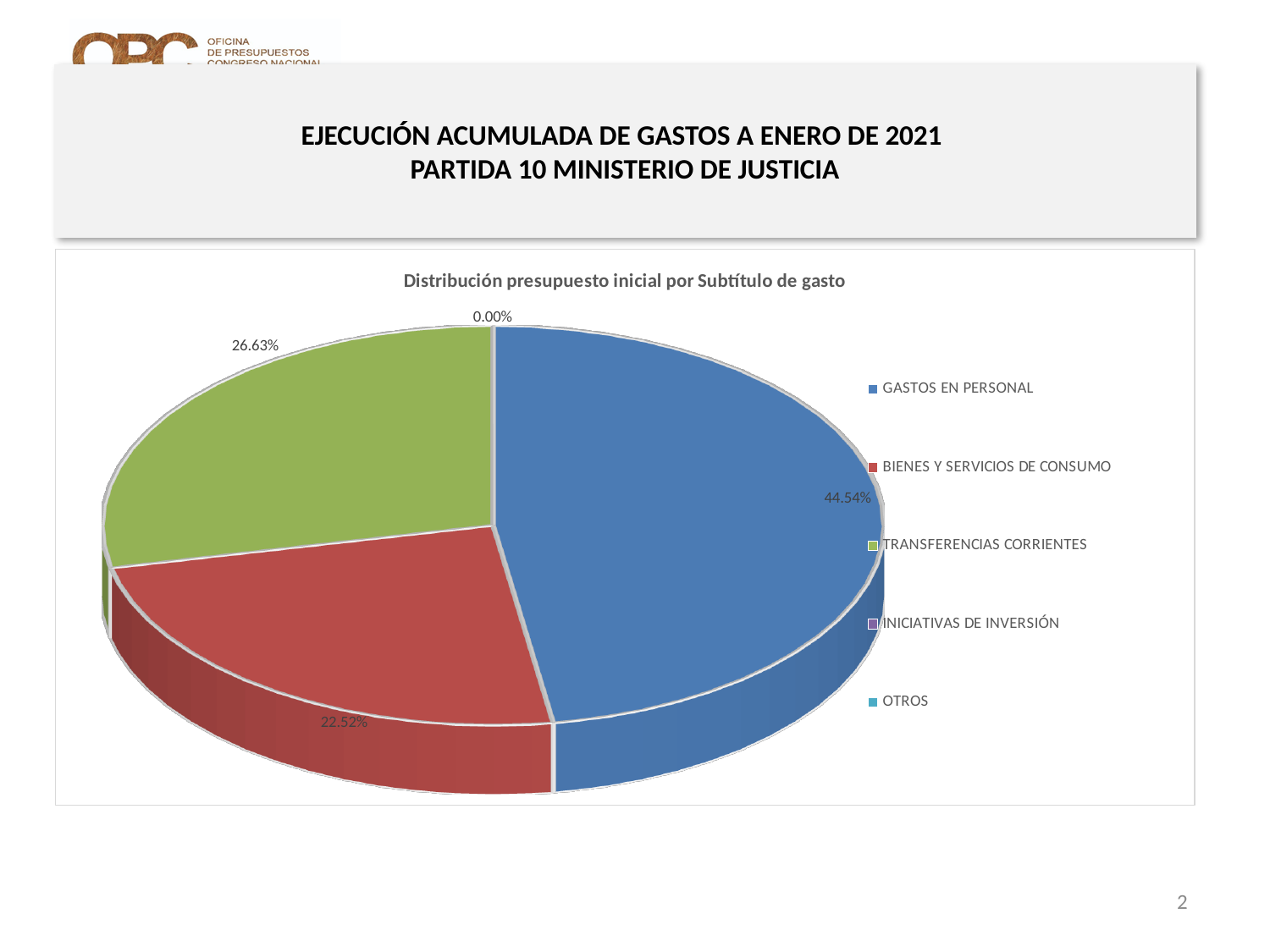
What share of the pie does BIENES Y SERVICIOS DE CONSUMO represent? 22.52% How many categories are listed in the chart legend? 5 Which category has the largest share of the pie? GASTOS EN PERSONAL By how many percentage points does the share of TRANSFERENCIAS CORRIENTES exceed that of BIENES Y SERVICIOS DE CONSUMO? 4.11 What share of the pie does TRANSFERENCIAS CORRIENTES represent? 26.63% What colour is the GASTOS EN PERSONAL slice? blue Which has the larger share, TRANSFERENCIAS CORRIENTES or BIENES Y SERVICIOS DE CONSUMO? TRANSFERENCIAS CORRIENTES What is the combined share of GASTOS EN PERSONAL, BIENES Y SERVICIOS DE CONSUMO and TRANSFERENCIAS CORRIENTES? 93.69% By how many percentage points does the share of GASTOS EN PERSONAL exceed that of TRANSFERENCIAS CORRIENTES? 17.91 What is the title of the chart? Distribución presupuesto inicial por Subtítulo de gasto What kind of chart is shown on the slide? pie chart What share of the pie does GASTOS EN PERSONAL represent? 44.54%